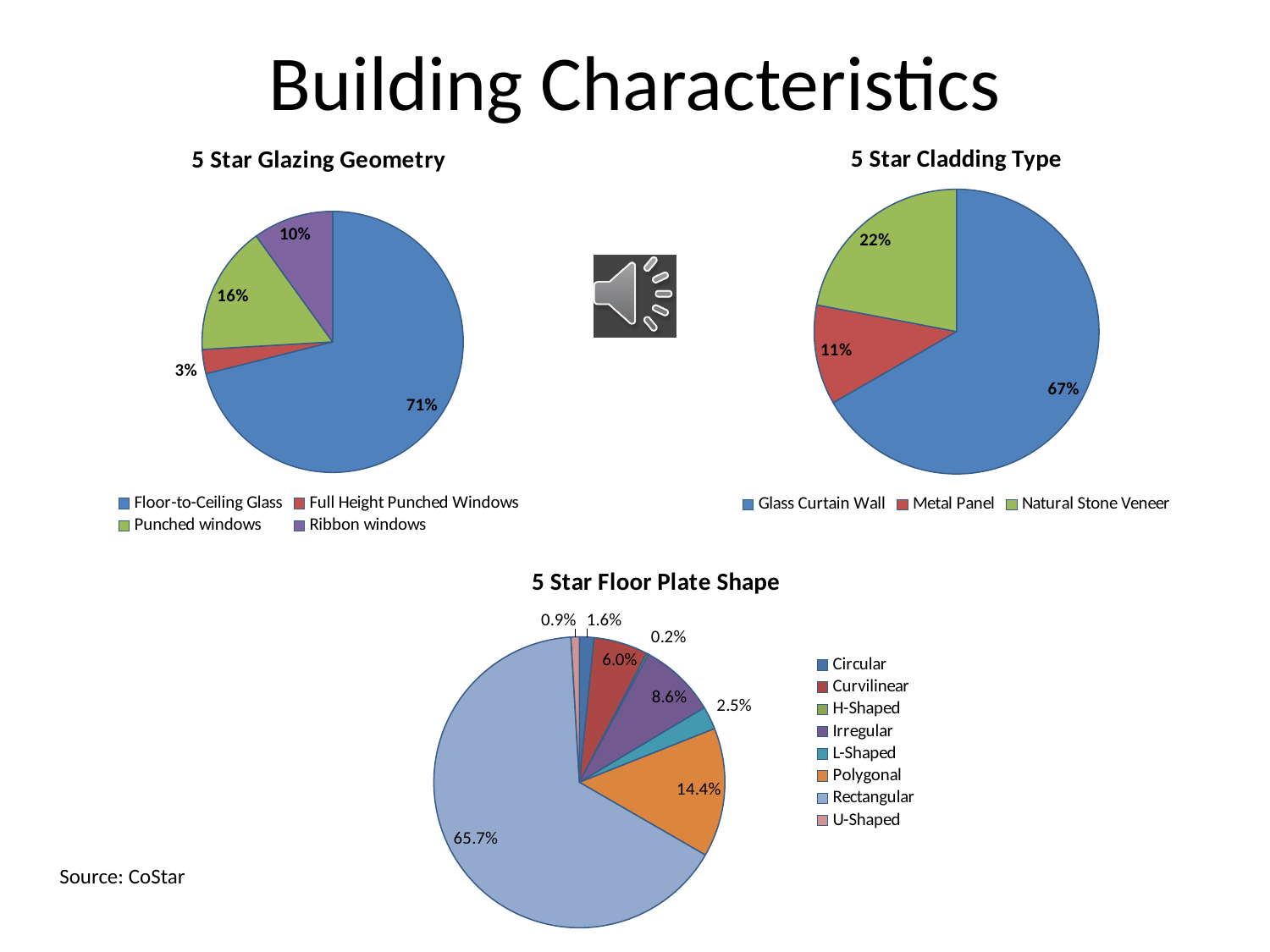
In the 5 Star Glazing Geometry chart, which category has the smallest share? Full Height Punched Windows How many categories does the legend of the 5 Star Floor Plate Shape chart list? 8 In the 5 Star Glazing Geometry chart, what share is Floor-to-Ceiling Glass? 71% What kind of chart is the 5 Star Cladding Type chart? Pie chart How many categories does the 5 Star Glazing Geometry chart show? 4 In the 5 Star Floor Plate Shape chart, what is the difference between the Rectangular share and the Polygonal share? 51.3% In the 5 Star Floor Plate Shape chart, which category has the smallest share? H-Shaped In the 5 Star Cladding Type chart, which is larger, Metal Panel or Natural Stone Veneer? Natural Stone Veneer In the 5 Star Cladding Type chart, which category has the largest share? Glass Curtain Wall In the 5 Star Glazing Geometry chart, what is the difference between the Punched windows share and the Ribbon windows share? 6% In the 5 Star Floor Plate Shape chart, what share is Polygonal? 14.4% In the 5 Star Cladding Type chart, what share is Natural Stone Veneer? 22%